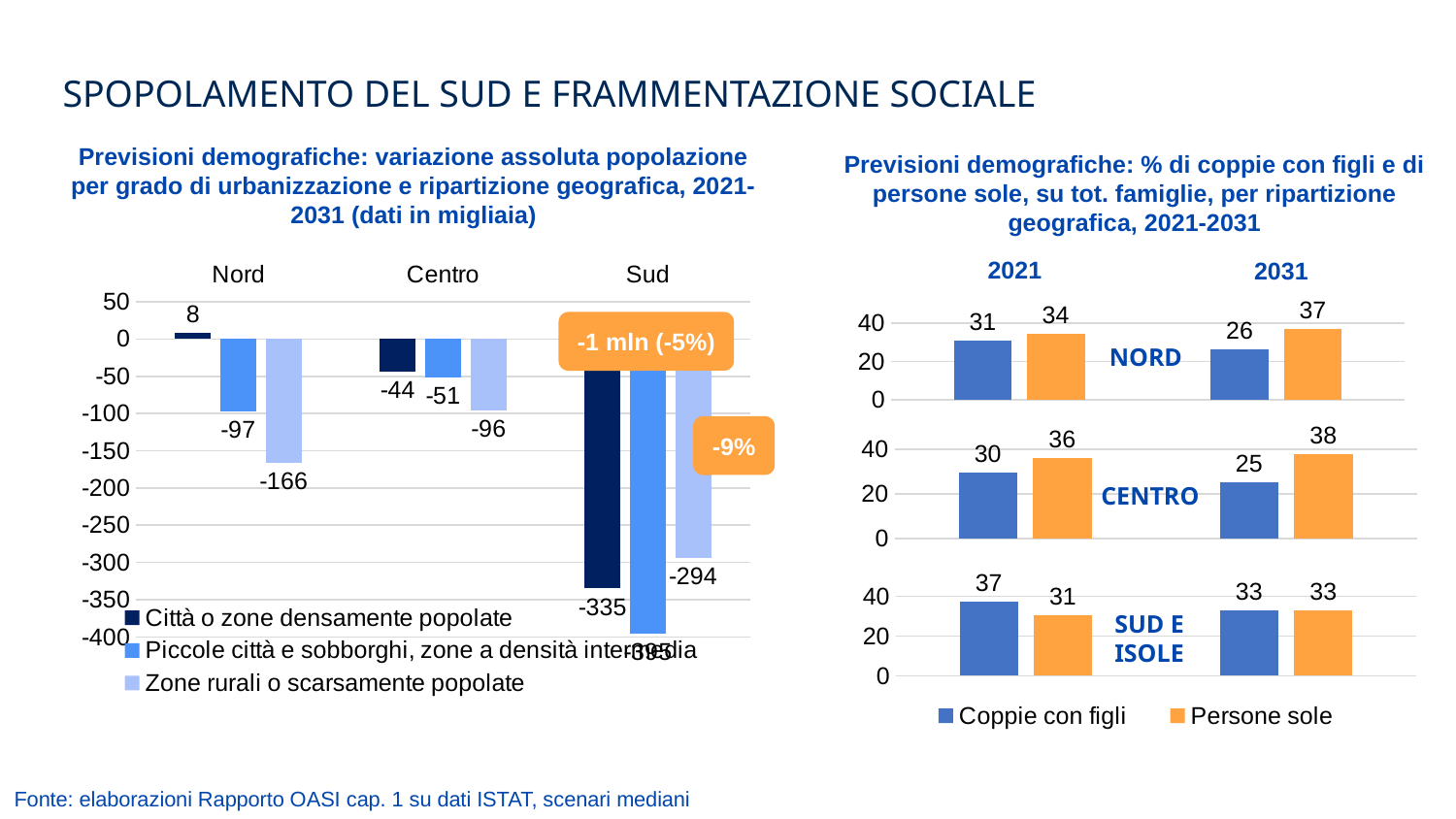
In the right chart (% di coppie con figli e di persone sole), what is the difference between Coppie con figli and Persone sole in SUD E ISOLE in 2021? 6 In the left chart (Previsioni demografiche: variazione assoluta popolazione), how many series does the legend list? 3 In the left chart (Previsioni demografiche: variazione assoluta popolazione), what is the value for Città o zone densamente popolate in Sud? -335 In the left chart (Previsioni demografiche: variazione assoluta popolazione), what is the difference between the Piccole città e sobborghi value (-97) and the Zone rurali value (-166) in Nord? 69 In the right chart (% di coppie con figli e di persone sole), what is the value for Coppie con figli in SUD E ISOLE in 2021? 37 In the right chart (% di coppie con figli e di persone sole), which is larger in NORD in 2021: Coppie con figli or Persone sole? Persone sole In the right chart (% di coppie con figli e di persone sole), what is the value for Persone sole in NORD in 2031? 37 In the left chart (Previsioni demografiche: variazione assoluta popolazione), what is the value for Piccole città e sobborghi, zone a densità intermedia in Centro? -51 What kind of chart is the left chart (Previsioni demografiche: variazione assoluta popolazione)? Bar chart In the right chart (% di coppie con figli e di persone sole), does the value for Coppie con figli in CENTRO rise or fall from 2021 to 2031? Fall In the left chart (Previsioni demografiche: variazione assoluta popolazione), what is the value for Città o zone densamente popolate in Nord? 8 In the left chart (Previsioni demografiche: variazione assoluta popolazione), what is the value for Zone rurali o scarsamente popolate in Nord? -166